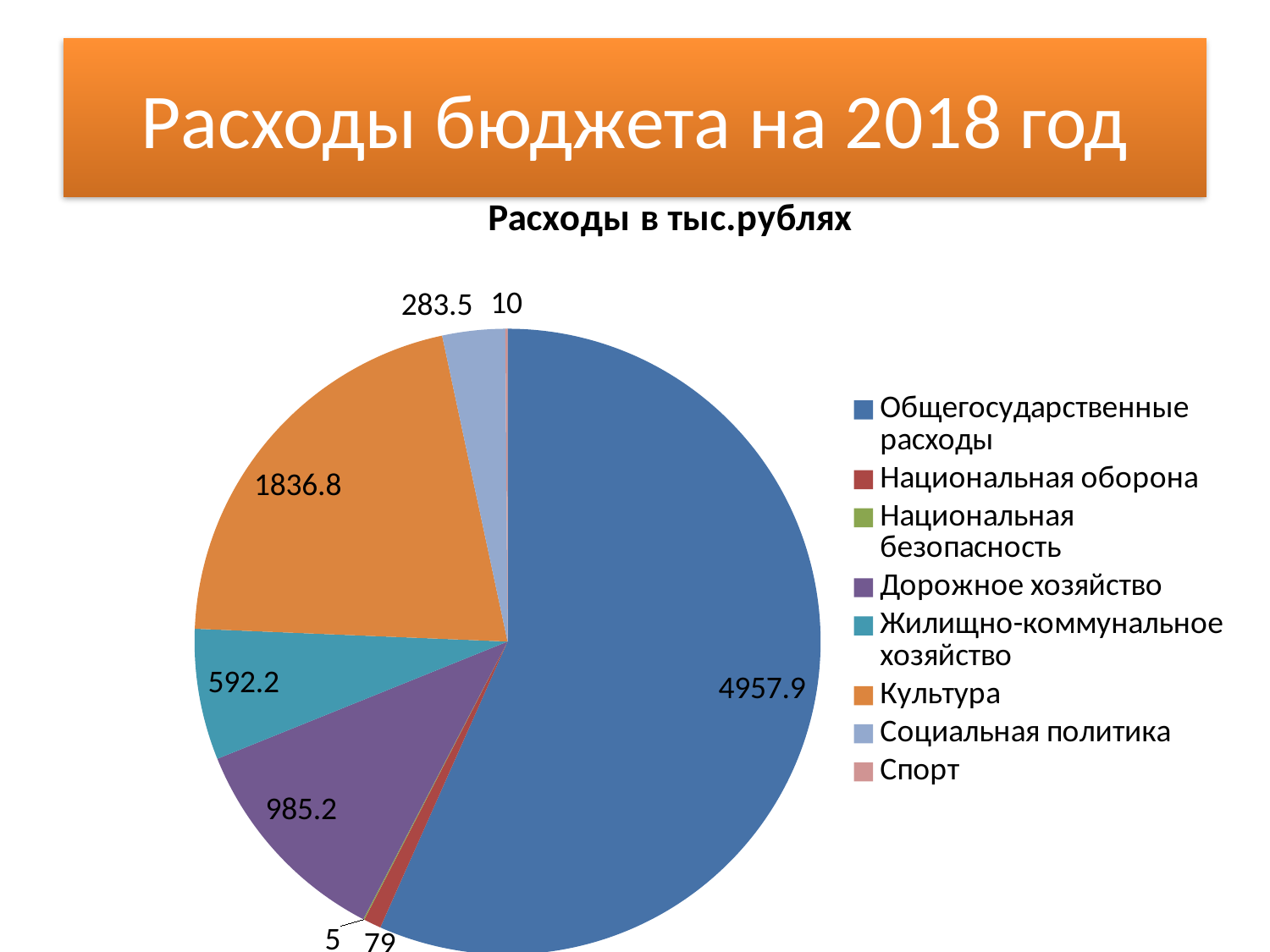
Which is larger, the value for Дорожное хозяйство or the value for Жилищно-коммунальное хозяйство? Дорожное хозяйство What kind of chart is shown on the slide? pie chart What is the value for Социальная политика? 283.5 What is the value for Жилищно-коммунальное хозяйство? 592.2 What is the value for Дорожное хозяйство? 985.2 Which category has the largest slice of the pie? Общегосударственные расходы What is the title of the chart? Расходы в тыс.рублях What is the value for Культура? 1836.8 Which category has the smallest slice of the pie? Национальная безопасность What is the difference between the values for Общегосударственные расходы and Культура? 3121.1 How many categories does the legend of the pie chart list? 8 What is the value for Общегосударственные расходы? 4957.9